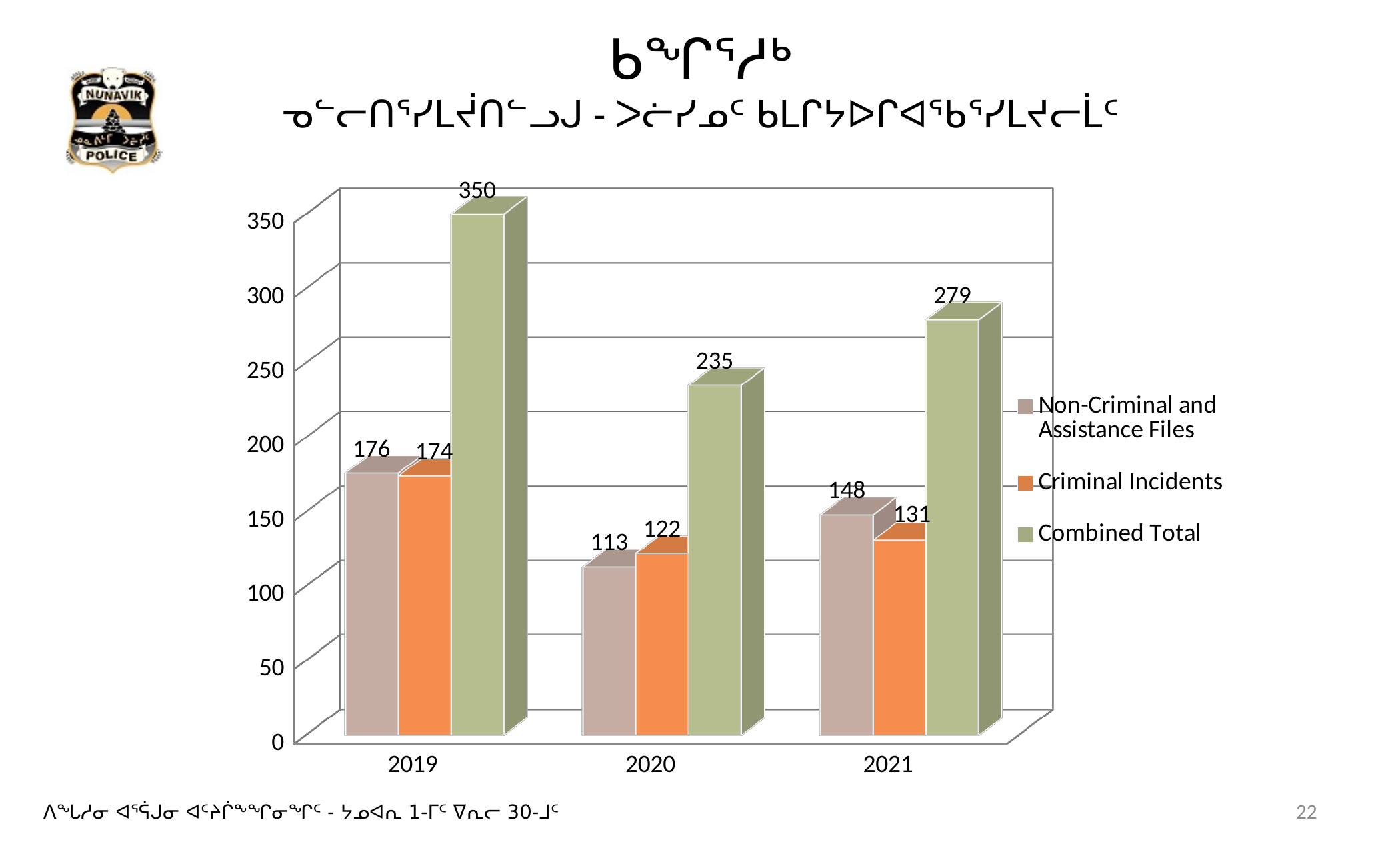
In which year is the Non-Criminal and Assistance Files value lowest? 2020 What is the difference between the Combined Total in 2019 and in 2020? 115 What is the value of Non-Criminal and Assistance Files in 2019? 176 What kind of chart is shown on the slide? bar chart Which series is shown in orange in the legend? Criminal Incidents What is the value of Criminal Incidents in 2021? 131 What is the value of Criminal Incidents in 2020? 122 In which year is the Combined Total highest? 2019 How many years are shown on the x axis? 3 How many series does the legend list? 3 Which is larger in 2021: Non-Criminal and Assistance Files or Criminal Incidents? Non-Criminal and Assistance Files What is the Combined Total for 2021? 279